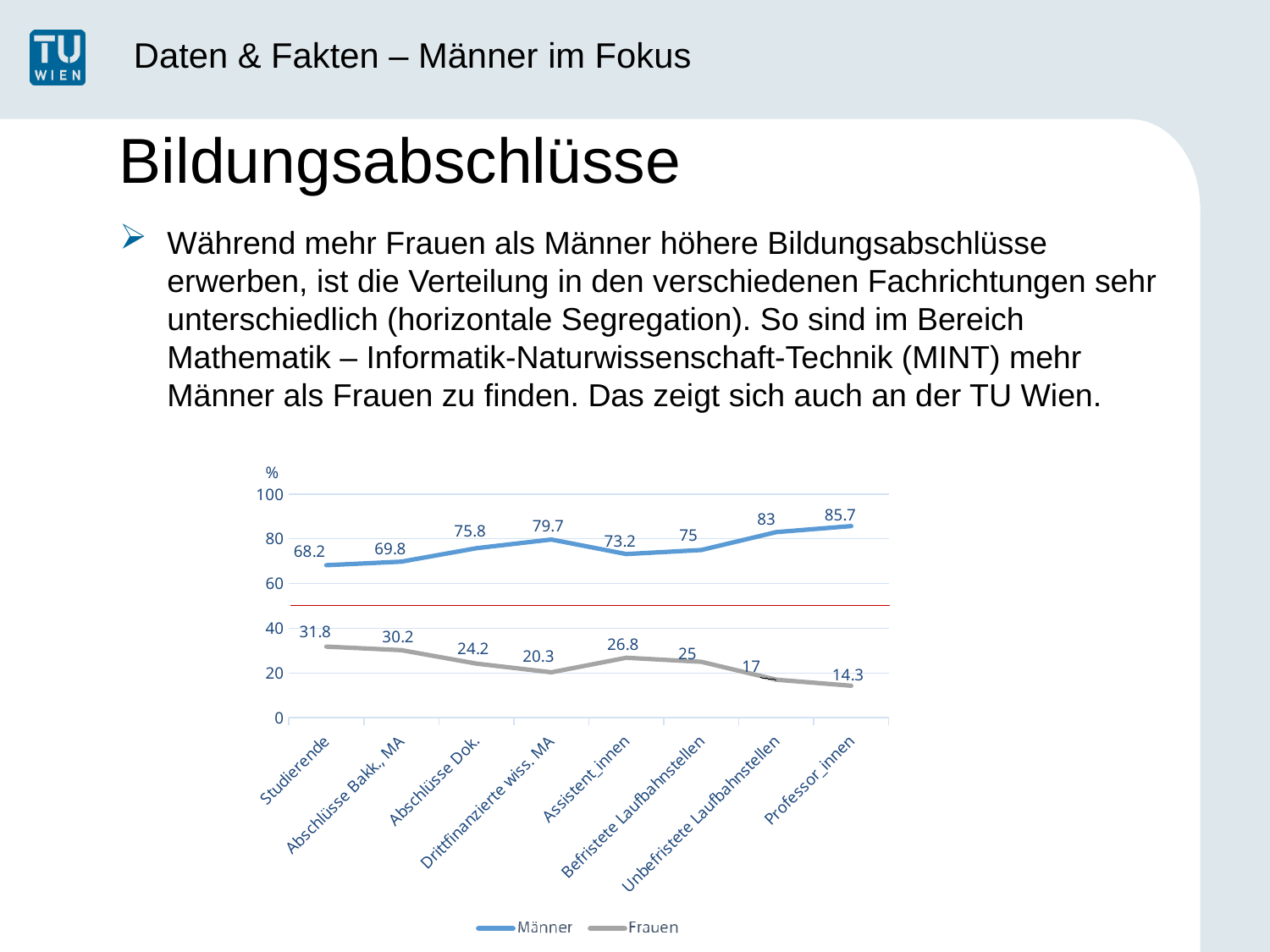
Which colour represents the Frauen series in the chart? grey How many series does the legend list? 2 How many categories are shown on the x axis? 8 What is the value for Männer in the Studierende category? 68.2 Which category has the highest value for Männer? Professor_innen What is the value for Frauen in the Professor_innen category? 14.3 Is the Männer value for Unbefristete Laufbahnstellen greater or less than 80? greater Which category has the lowest value for Frauen? Professor_innen Which is larger: the Frauen value for Studierende or the Frauen value for Befristete Laufbahnstellen? Studierende What is the value for Frauen in the Drittfinanzierte wiss. MA category? 20.3 What is the difference between the Männer and Frauen values for Assistent_innen? 46.4 What kind of chart is shown on the slide? line chart